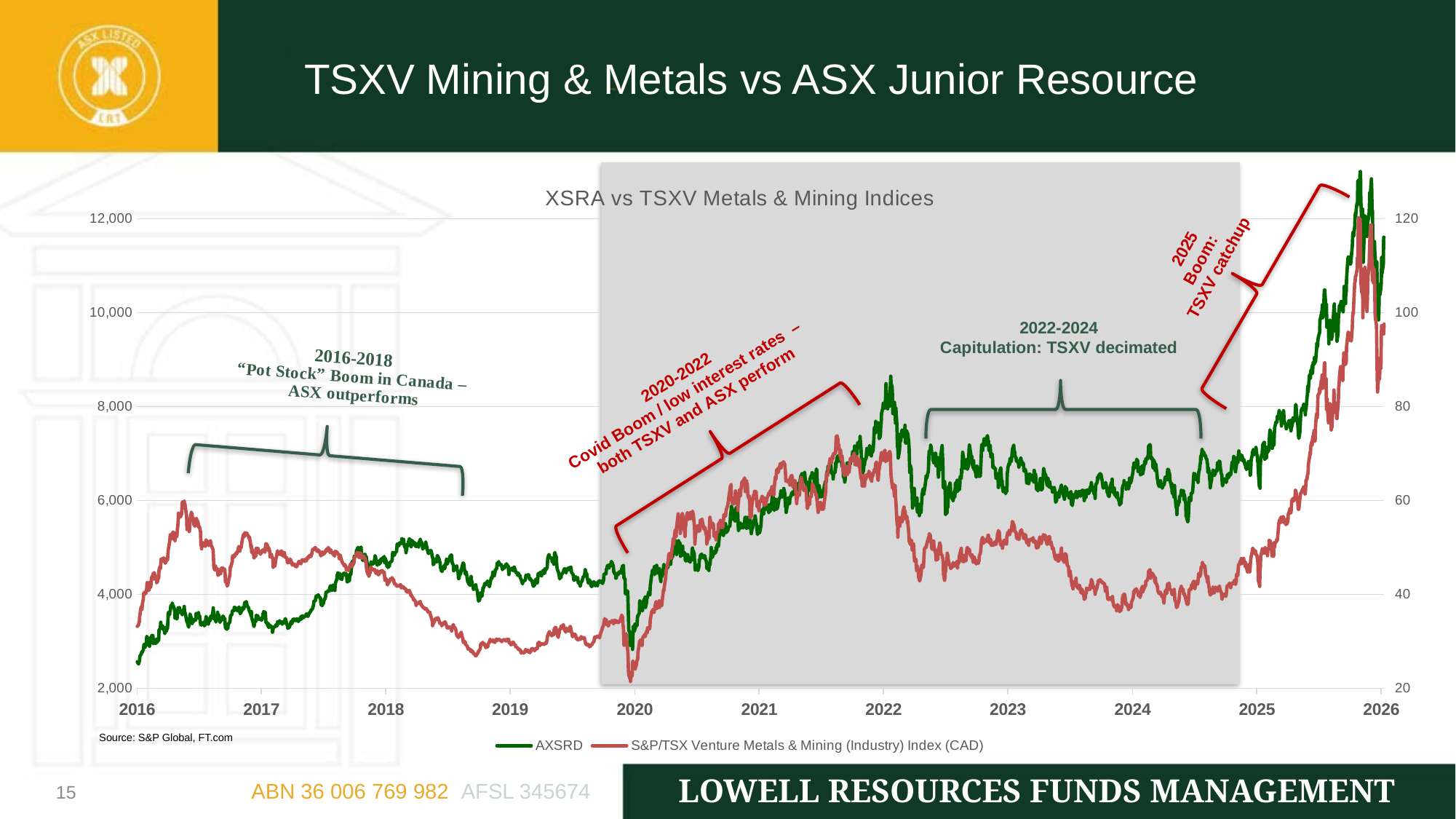
What is the highest value labelled on the left y axis of the chart? 12,000 Is the S&P/TSX Venture Metals & Mining Index value during 2023 greater or less than 60 on the right axis? less How many series does the chart legend list? 2 What kind of chart is shown on the slide? Line chart Is the S&P/TSX Venture Metals & Mining Index value at its late-2025 peak greater or less than 100 on the right axis? greater Overall, does the AXSRD line rise or fall from 2016 to 2026? Rise Is the AXSRD value at the start of 2016 greater or less than 4,000? less What is the title of the chart? XSRA vs TSXV Metals & Mining Indices Which series is drawn in green in the chart? AXSRD How many year labels are shown on the x axis of the chart? 11